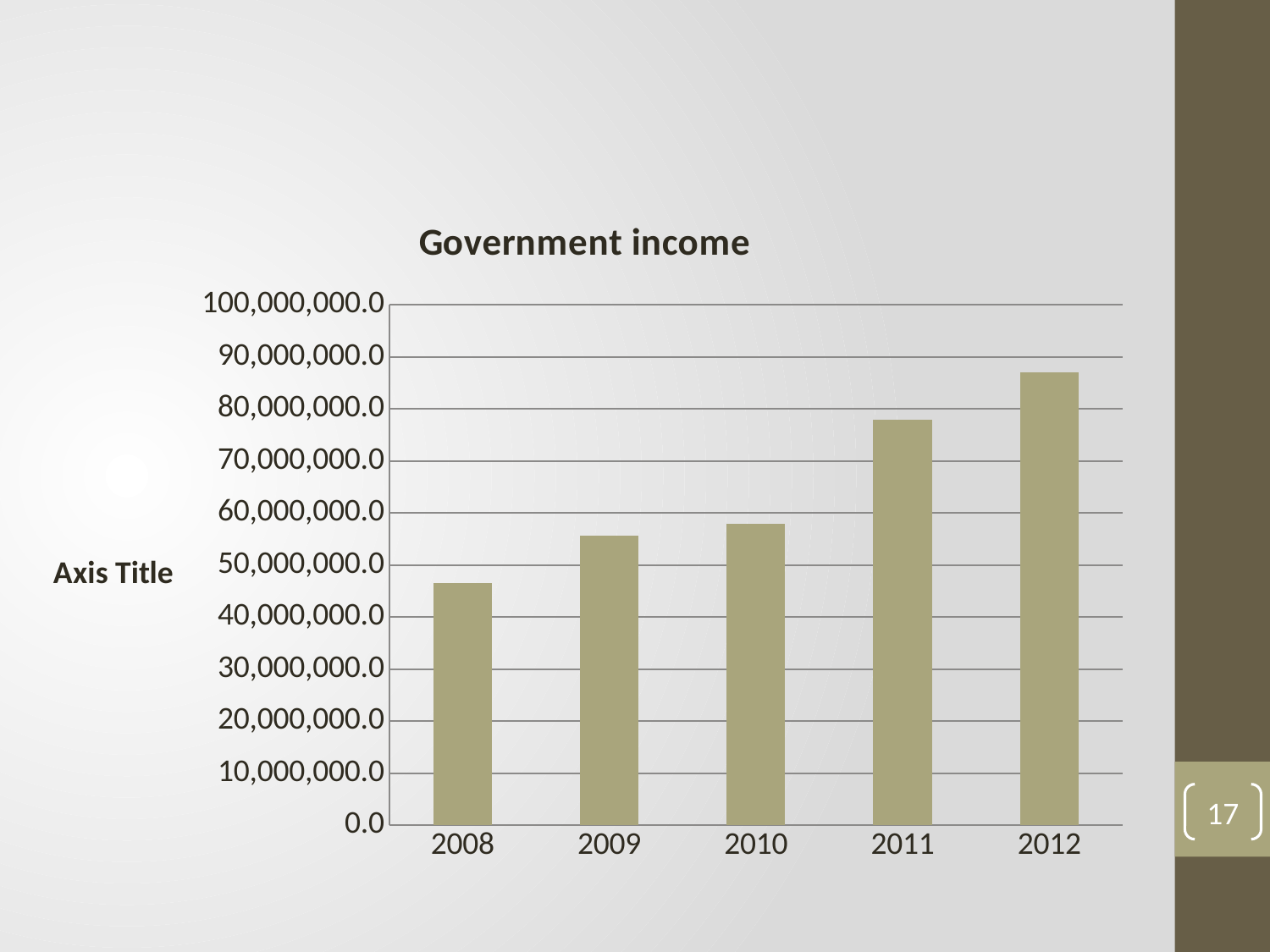
Is the value for 2008 greater or less than 50,000,000.0? less Which year has the highest government income? 2012 Is the value for 2012 greater or less than 80,000,000.0? greater How many years are shown on the x axis of the chart? 5 What kind of chart is shown on the slide? bar chart Do the values rise or fall from 2008 to 2012? rise What is the title of the chart? Government income Is the value for 2010 greater or less than 60,000,000.0? less What label is shown on the vertical axis of the chart? Axis Title Which is larger, the value for 2011 or the value for 2008? 2011 Which year has the lowest government income? 2008